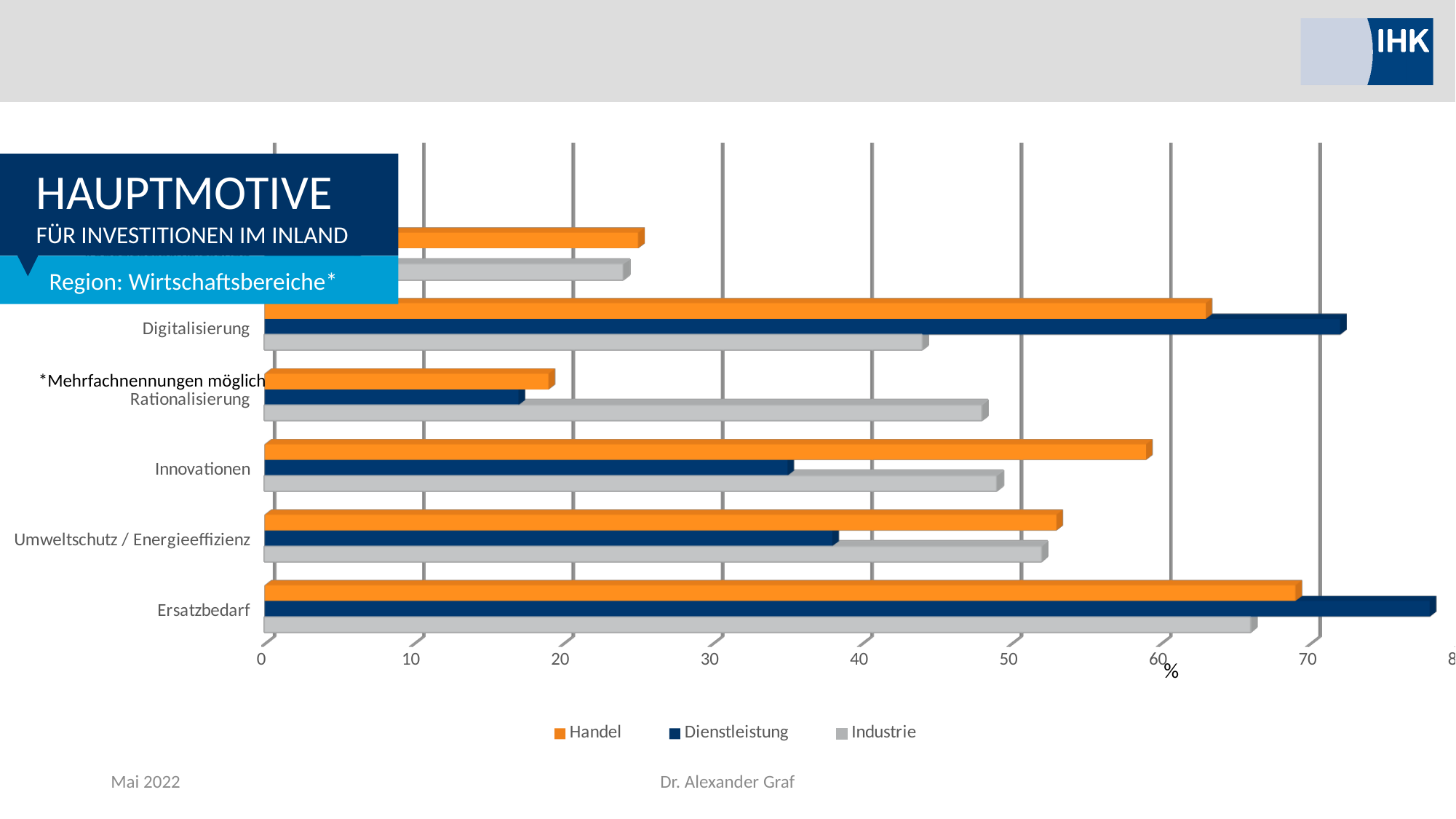
Is the Dienstleistung value for Rationalisierung greater or less than 20? less Which category has the highest Dienstleistung value? Ersatzbedarf Is the Dienstleistung value for Innovationen greater or less than 40? less For Rationalisierung, which is larger: the Handel value or the Industrie value? Industrie Is the Industrie value for Ersatzbedarf greater or less than 60? greater For Ersatzbedarf, which is larger: the Handel value or the Dienstleistung value? Dienstleistung For Innovationen, which is larger: the Handel value or the Dienstleistung value? Handel Which colour represents the Handel series in the legend? orange How many series does the legend list? 3 What kind of chart is shown on the slide? bar chart